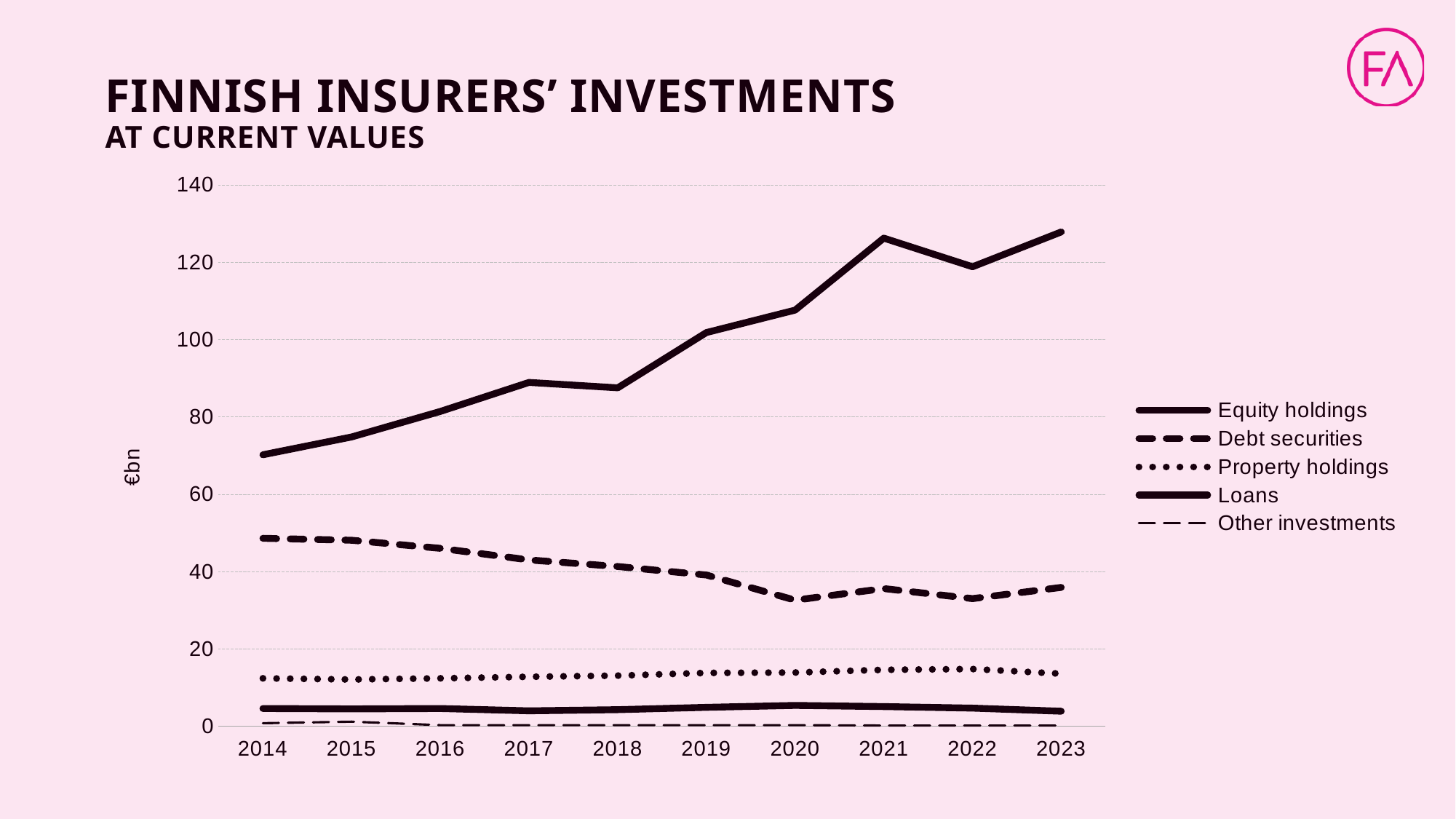
Is the value for Equity holdings in 2014 greater or less than 80? less Is the value for Equity holdings in 2023 greater or less than 120? greater What kind of chart is shown on the slide? line chart Which series has the lowest values across the chart? Other investments How many series does the legend list? 5 In 2023, which is larger: Equity holdings or Debt securities? Equity holdings Is the value for Debt securities in 2014 greater or less than 40? greater How many years are shown on the x axis? 10 What unit is shown on the y axis? €bn Do the values for Equity holdings rise or fall from 2014 to 2023? rise